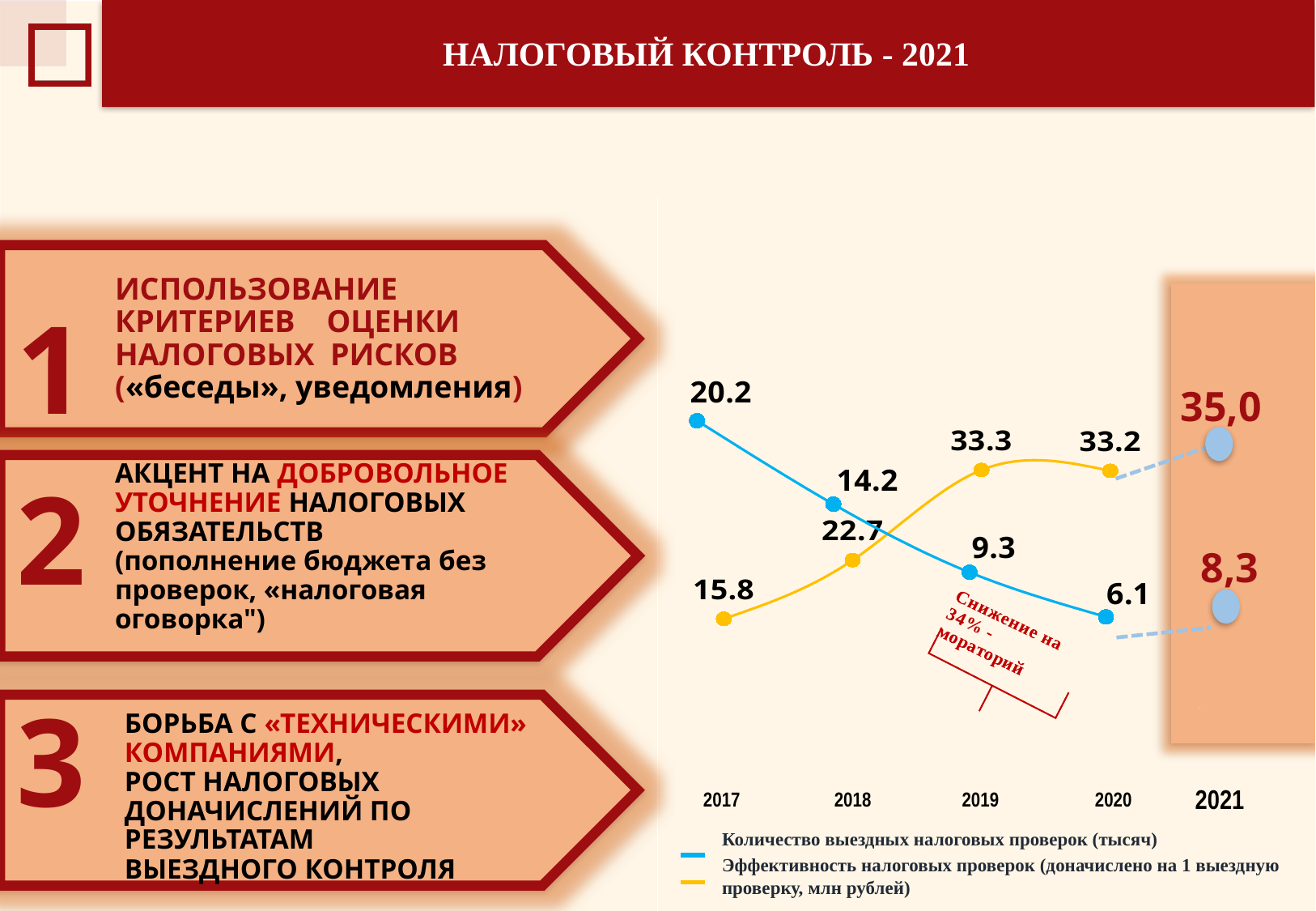
What value is shown for the yellow series (Эффективность налоговых проверок) in 2021? 35,0 In which year is the blue series (Количество выездных налоговых проверок) highest? 2017 How many series does the chart legend list? 2 What is the value of the blue series (Количество выездных налоговых проверок) for 2020? 6.1 How many years are shown on the x axis of the chart? 5 Does the blue series (Количество выездных налоговых проверок) rise or fall from 2017 to 2020? fall What is the value of the blue series (Количество выездных налоговых проверок) for 2017? 20.2 Which is larger in 2018: the blue series value or the yellow series value? the yellow series (22.7) What type of chart is shown on the slide? line chart What is the difference between the blue series values for 2017 and 2018? 6.0 In which year is the yellow series (Эффективность налоговых проверок) lowest? 2017 What is the value of the yellow series (Эффективность налоговых проверок) for 2019? 33.3